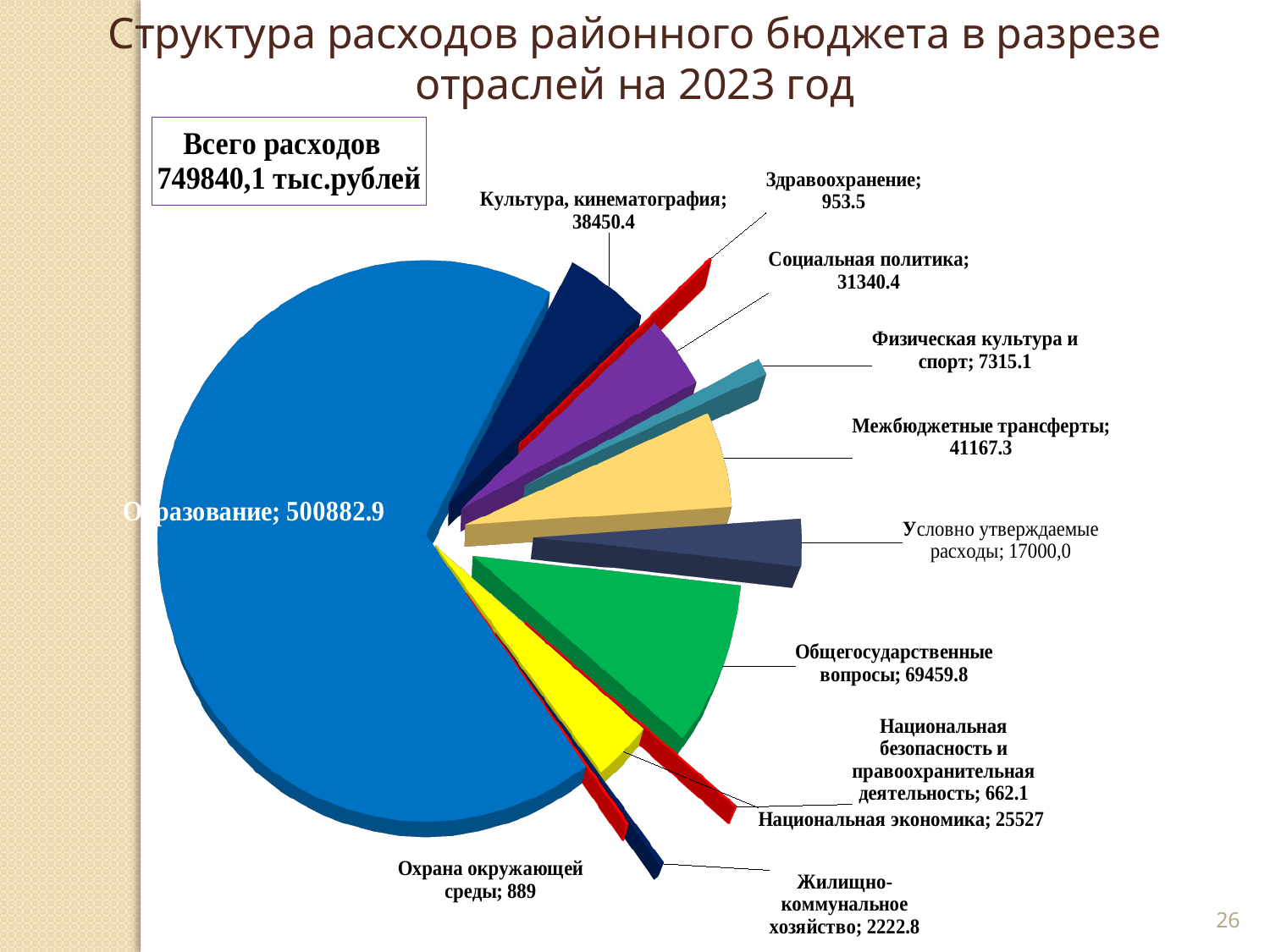
What is the value for Образование? 500882.9 What is the difference between Здравоохранение and Охрана окружающей среды? 64.5 What is the value for Межбюджетные трансферты? 41167.3 Which is larger, Культура, кинематография or Социальная политика? Культура, кинематография How many categories does the pie chart show? 12 What is the value for Жилищно-коммунальное хозяйство? 2222.8 What kind of chart is shown on the slide? Pie chart What is the difference between Общегосударственные вопросы and Межбюджетные трансферты? 28292.5 Which category has the smallest value? Национальная безопасность и правоохранительная деятельность What total expenditure is stated in the box on the slide? 749840,1 тыс.рублей Which category has the largest value? Образование What is the value for Национальная экономика? 25527